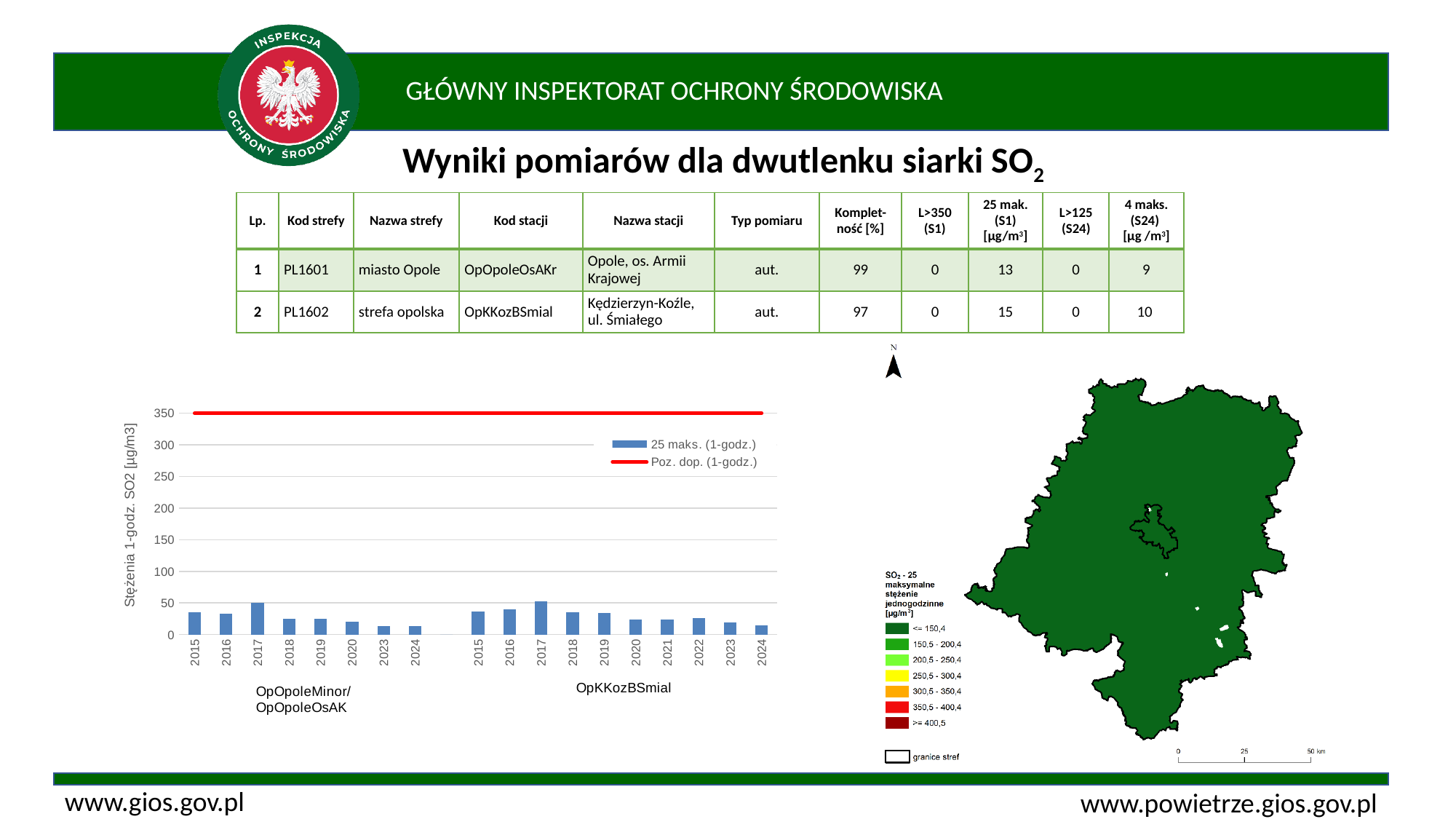
What are the two legend entries of the bar chart? 25 maks. (1-godz.) and Poz. dop. (1-godz.) How many bars are plotted for the OpKKozBSmial station in the bar chart? 10 In the bar chart, which is larger for OpKKozBSmial: the 2017 value or the 2024 value? 2017 In the bar chart, is the 2017 value for OpOpoleMinor/OpOpoleOsAK greater or less than 100? less At what value does the red Poz. dop. (1-godz.) line sit on the bar chart? 350 In the bar chart, which year has the lowest bar for the OpKKozBSmial station? 2024 In the bar chart, which year has the highest bar for the OpOpoleMinor/OpOpoleOsAK station? 2017 How many series does the legend of the bar chart list? 2 What is the y-axis label of the bar chart? Stężenia 1-godz. SO2 [µg/m3] How many bars are plotted for the OpOpoleMinor/OpOpoleOsAK station in the bar chart? 8 In the bar chart, which year has the highest bar for the OpKKozBSmial station? 2017 What kind of chart is shown on the left of the slide? bar chart